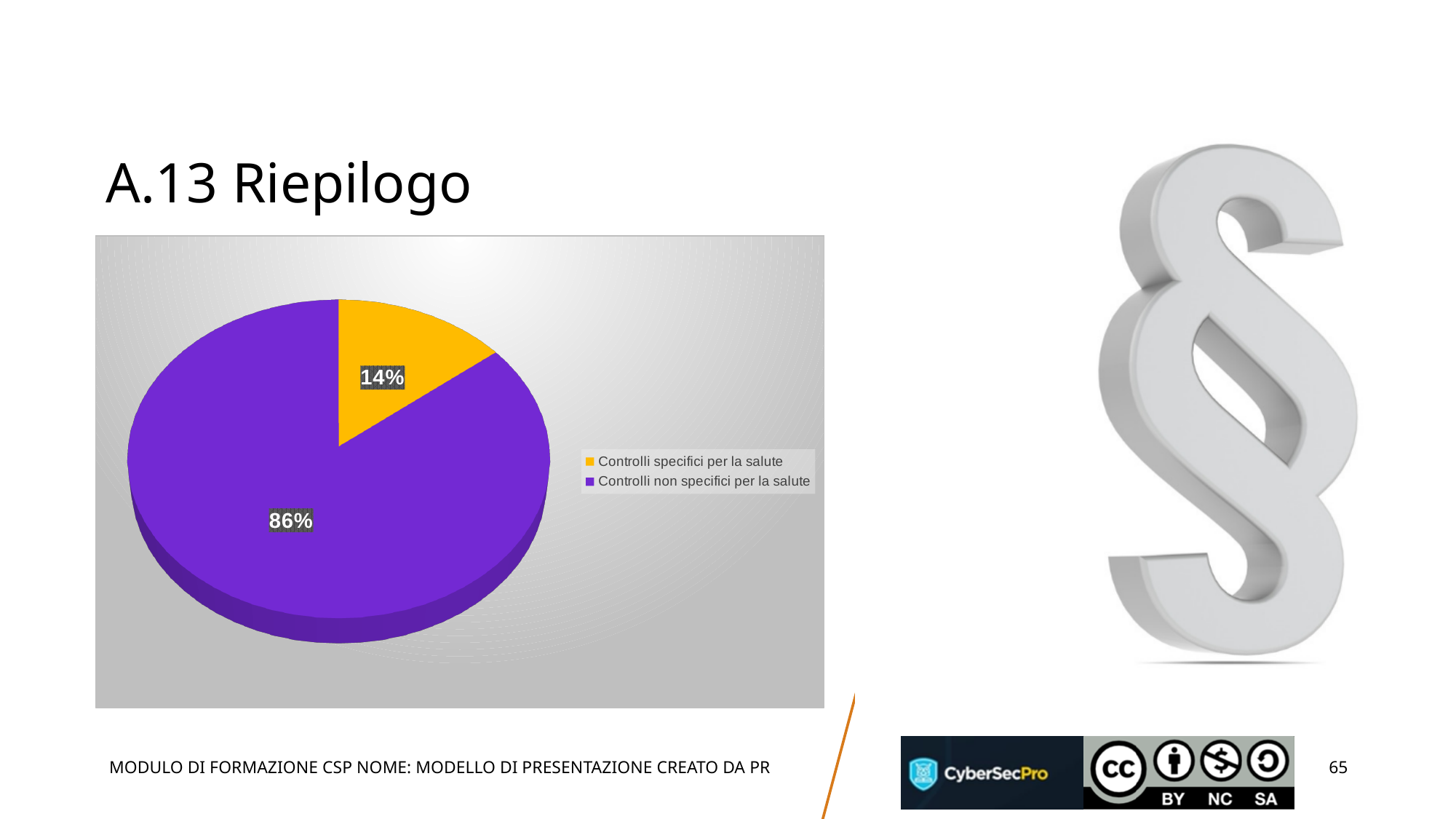
Which slice of the pie chart is the largest? Controlli non specifici per la salute What percentage of the pie is labelled "Controlli specifici per la salute"? 14% What percentage of the pie is labelled "Controlli non specifici per la salute"? 86% What is the difference in percentage points between the "Controlli non specifici per la salute" slice and the "Controlli specifici per la salute" slice? 72 What kind of chart is shown on the slide? Pie chart How many entries does the chart legend list? 2 What share of the pie does the "Controlli specifici per la salute" slice represent? 14% Which slice of the pie chart is the smallest? Controlli specifici per la salute What colour is the "Controlli non specifici per la salute" slice? Purple How many slices does the pie chart have? 2 What colour is the "Controlli specifici per la salute" slice? Orange Which is larger: the share for "Controlli specifici per la salute" or for "Controlli non specifici per la salute"? Controlli non specifici per la salute